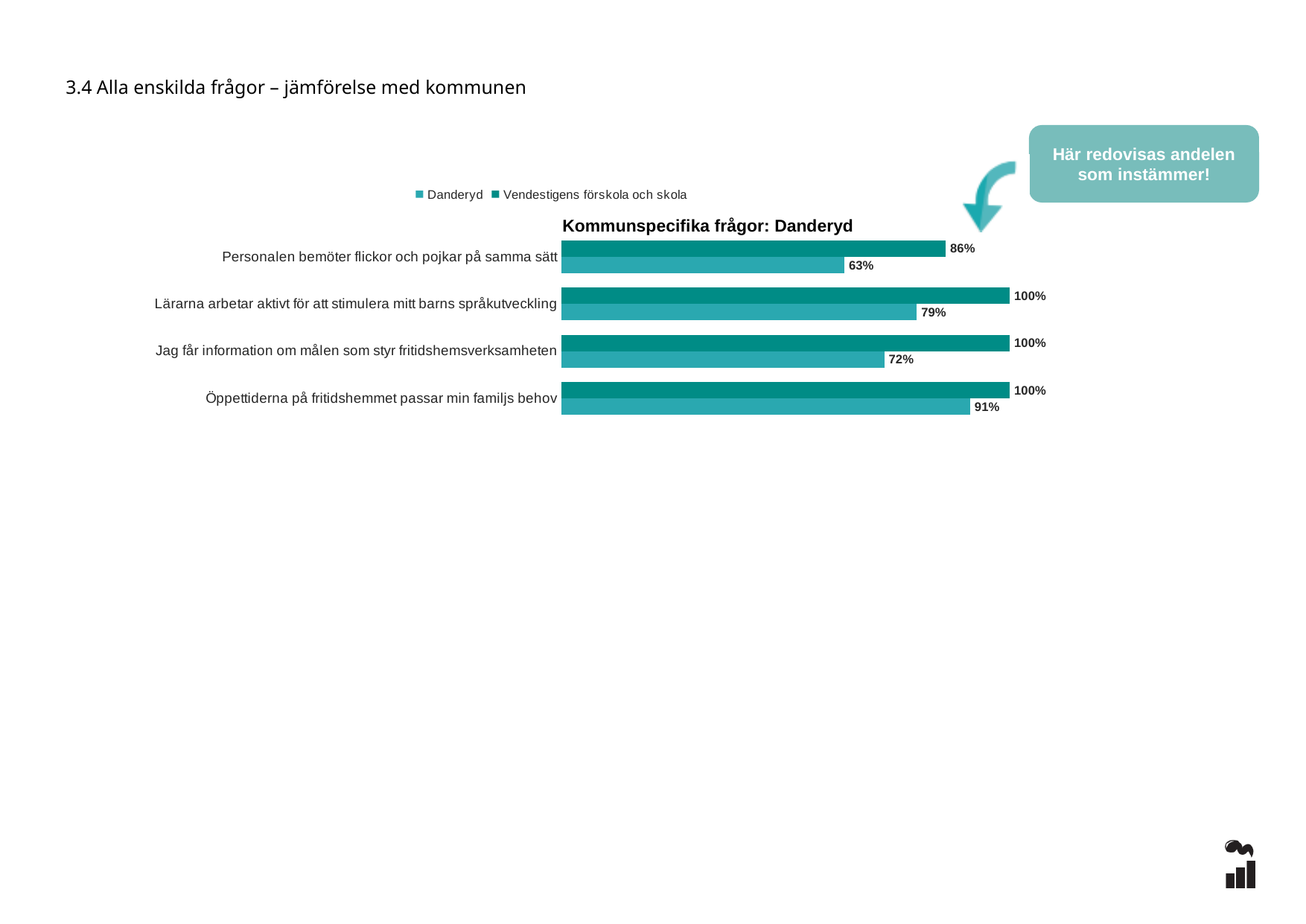
Which category has the highest value for Danderyd? Öppettiderna på fritidshemmet passar min familjs behov What is the value for Danderyd for "Lärarna arbetar aktivt för att stimulera mitt barns språkutveckling"? 79% Which category has the lowest value for Danderyd? Personalen bemöter flickor och pojkar på samma sätt What is the title of the chart? Kommunspecifika frågor: Danderyd What is the value for Vendestigens förskola och skola for "Personalen bemöter flickor och pojkar på samma sätt"? 86% How many categories (questions) are plotted in the chart? 4 How many series does the legend list? 2 What is the difference between Vendestigens förskola och skola and Danderyd for "Jag får information om målen som styr fritidshemsverksamheten"? 28% What is the value for Danderyd for "Personalen bemöter flickor och pojkar på samma sätt"? 63% What is the value for Vendestigens förskola och skola for "Öppettiderna på fritidshemmet passar min familjs behov"? 100% What kind of chart is shown on the slide? bar chart What is the value for Danderyd for "Jag får information om målen som styr fritidshemsverksamheten"? 72%